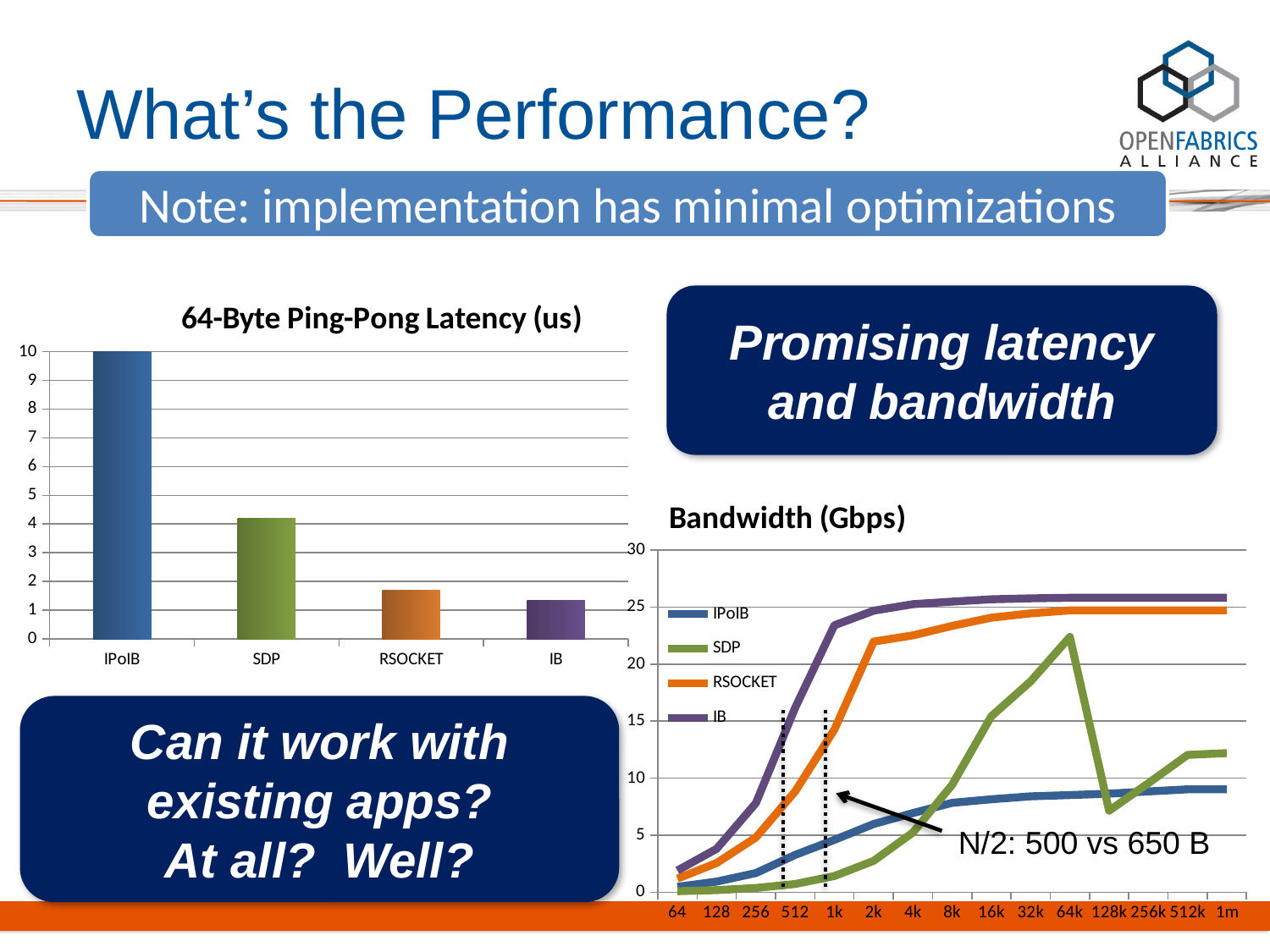
How many series does the legend of the Bandwidth (Gbps) chart list? 4 What kind of chart is the Bandwidth (Gbps) chart? line chart In the 64-Byte Ping-Pong Latency chart, which category has the highest latency? IPoIB In the Bandwidth (Gbps) chart, is the value for IPoIB at 1m greater or less than 10? less How many categories are shown in the 64-Byte Ping-Pong Latency chart? 4 What kind of chart is the 64-Byte Ping-Pong Latency chart? bar chart In the 64-Byte Ping-Pong Latency chart, which has the larger latency, SDP or RSOCKET? SDP In the 64-Byte Ping-Pong Latency chart, is the value for SDP greater or less than 5? less In the Bandwidth (Gbps) chart, does the IB series generally rise or fall as message size increases? rise In the 64-Byte Ping-Pong Latency chart, which category has the lowest latency? IB How many message sizes are shown on the x axis of the Bandwidth (Gbps) chart? 15